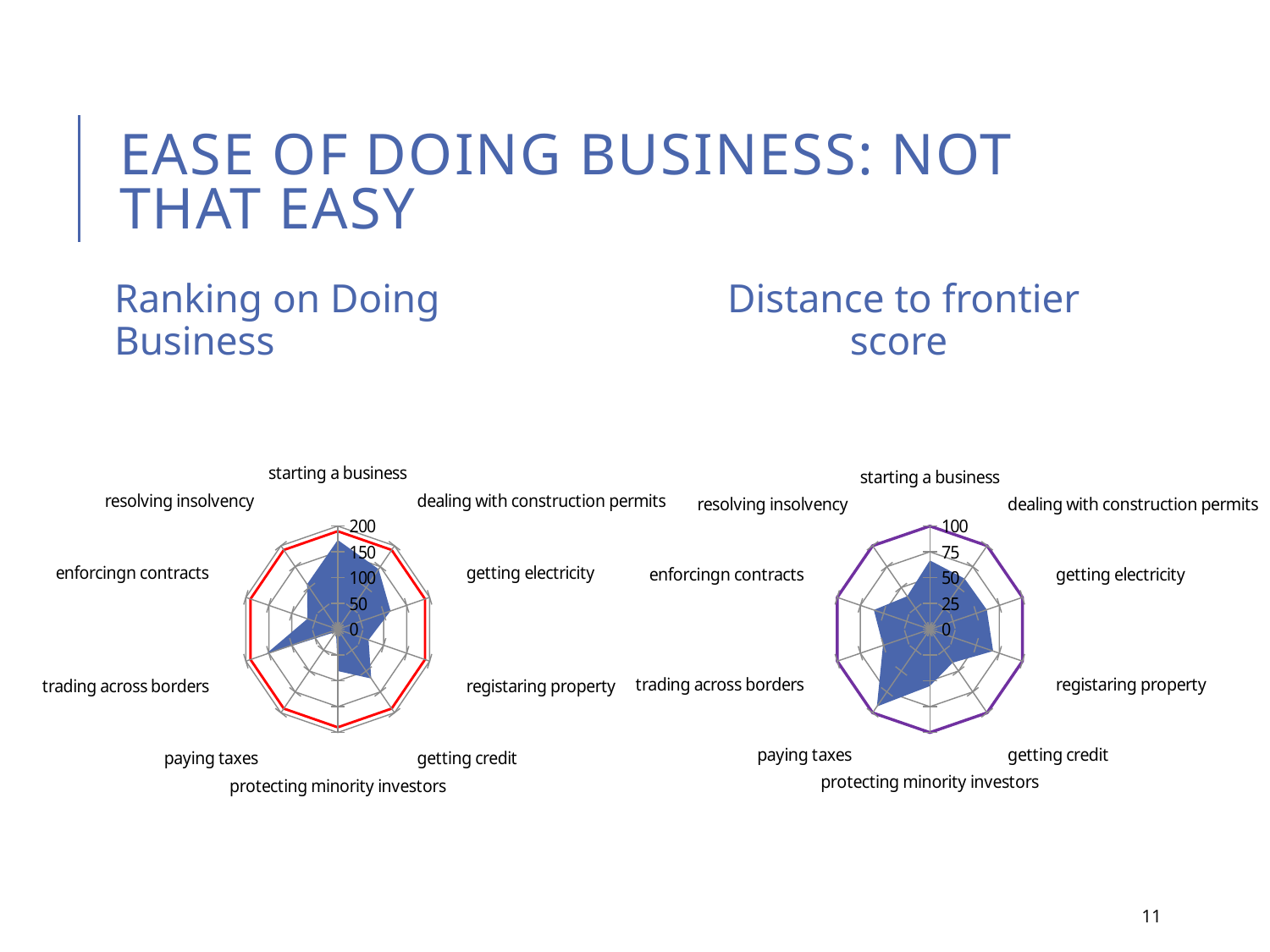
On the "Distance to frontier score" chart, is the value for paying taxes greater or less than 50? greater What kind of chart is the "Ranking on Doing Business" chart? radar chart How many categories are plotted on the "Ranking on Doing Business" chart? 10 On the "Ranking on Doing Business" chart, is the value for starting a business greater or less than 100? greater How many charts are shown on the slide? 2 What kind of chart is the "Distance to frontier score" chart? radar chart On the "Ranking on Doing Business" chart, is the value for trading across borders greater or less than 100? greater How many categories are plotted on the "Distance to frontier score" chart? 10 On the "Distance to frontier score" chart, what is the highest value shown on the axis scale? 100 On the "Ranking on Doing Business" chart, what is the highest value shown on the axis scale? 200